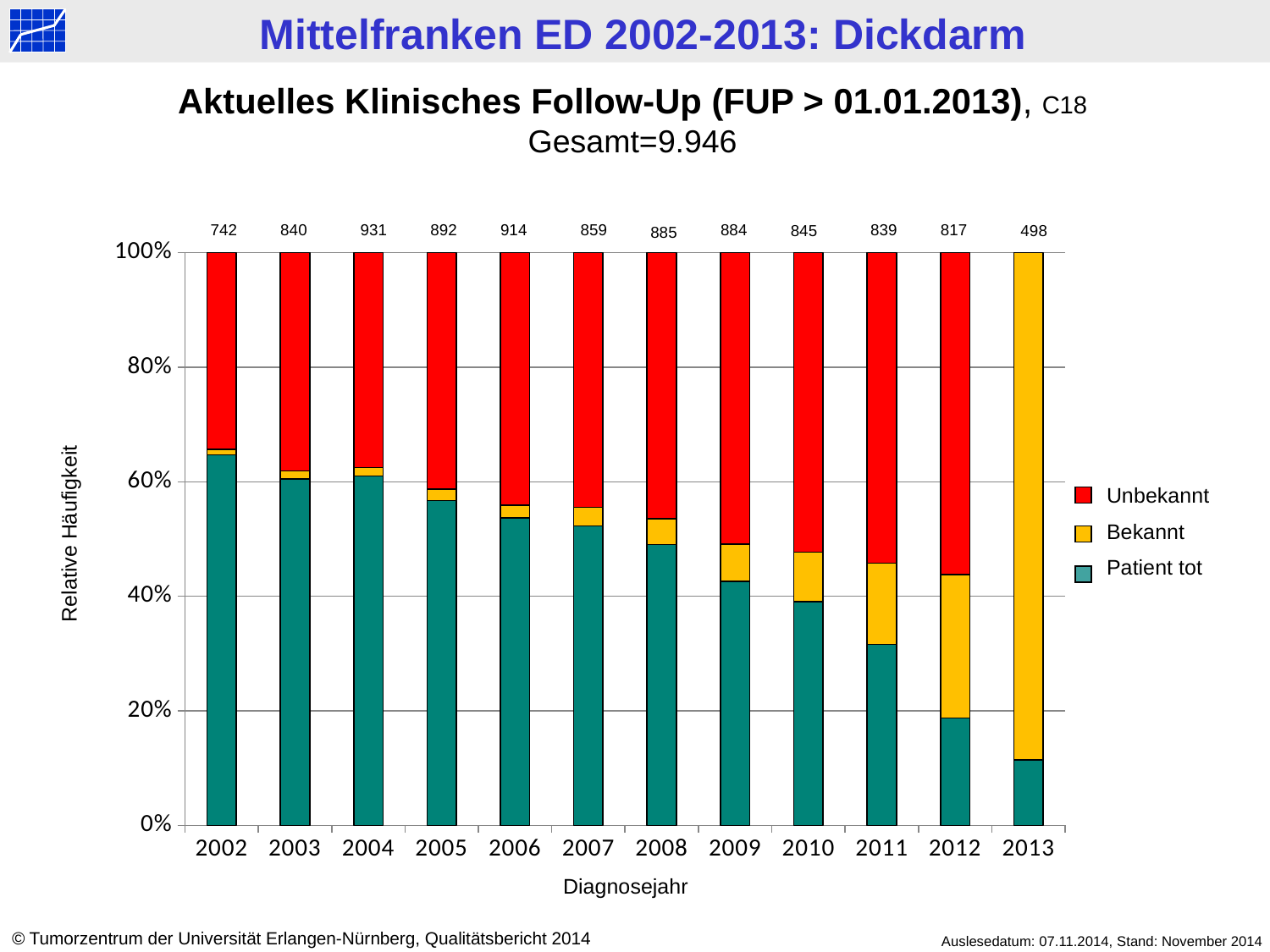
Which diagnosis year has the lowest number printed above its bar? 2013 What is the number printed above the bar for 2004? 931 How many series does the legend list? 3 What is the number printed above the bar for 2013? 498 Which diagnosis year has the highest number printed above its bar? 2004 Is the 'Patient tot' share for 2013 greater or less than 20%? less Does the 'Patient tot' share rise or fall from 2002 to 2013? Fall Which year has the larger number printed above its bar, 2002 or 2003? 2003 How many diagnosis years are shown on the x axis? 12 What kind of chart is shown on the slide? Stacked bar chart What is the difference between the numbers printed above the bars for 2004 and 2013? 433 Is the 'Patient tot' share for 2002 greater or less than 60%? greater